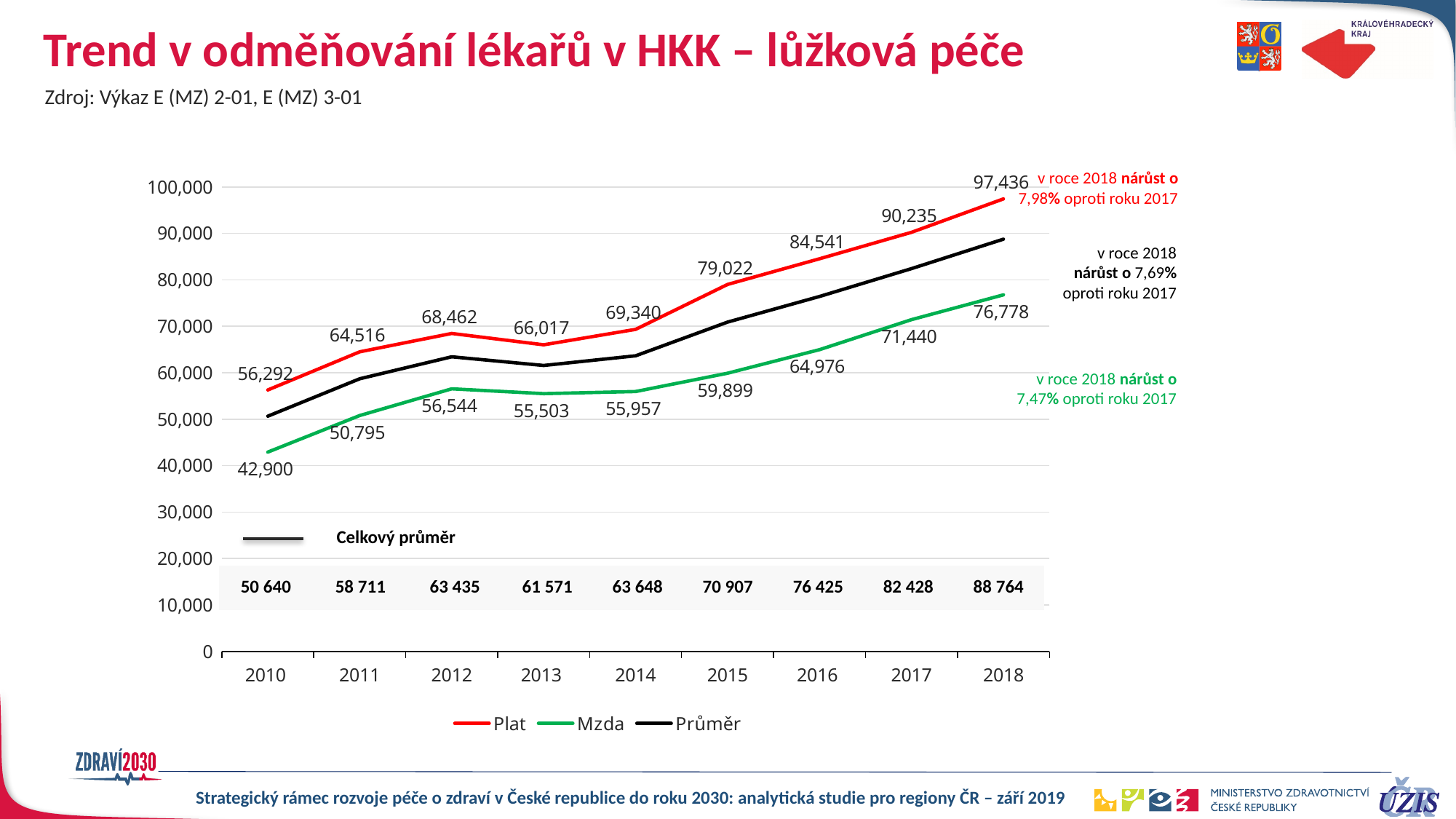
Which is larger in 2013, Plat or Mzda? Plat How many years are shown on the x axis? 9 In which year is the Plat series at its highest? 2018 What kind of chart is shown on the slide? line chart What is the value of Plat in 2018? 97,436 How many series does the legend list? 3 What is the Celkový průměr value shown for 2015? 70 907 Does the Plat series rise or fall between 2014 and 2018? rise Is the value of Mzda in 2016 greater or less than 60,000? greater In which year is the Mzda series at its lowest? 2010 What is the value of Mzda in 2010? 42,900 What is the difference between Plat and Mzda in 2018? 20,658